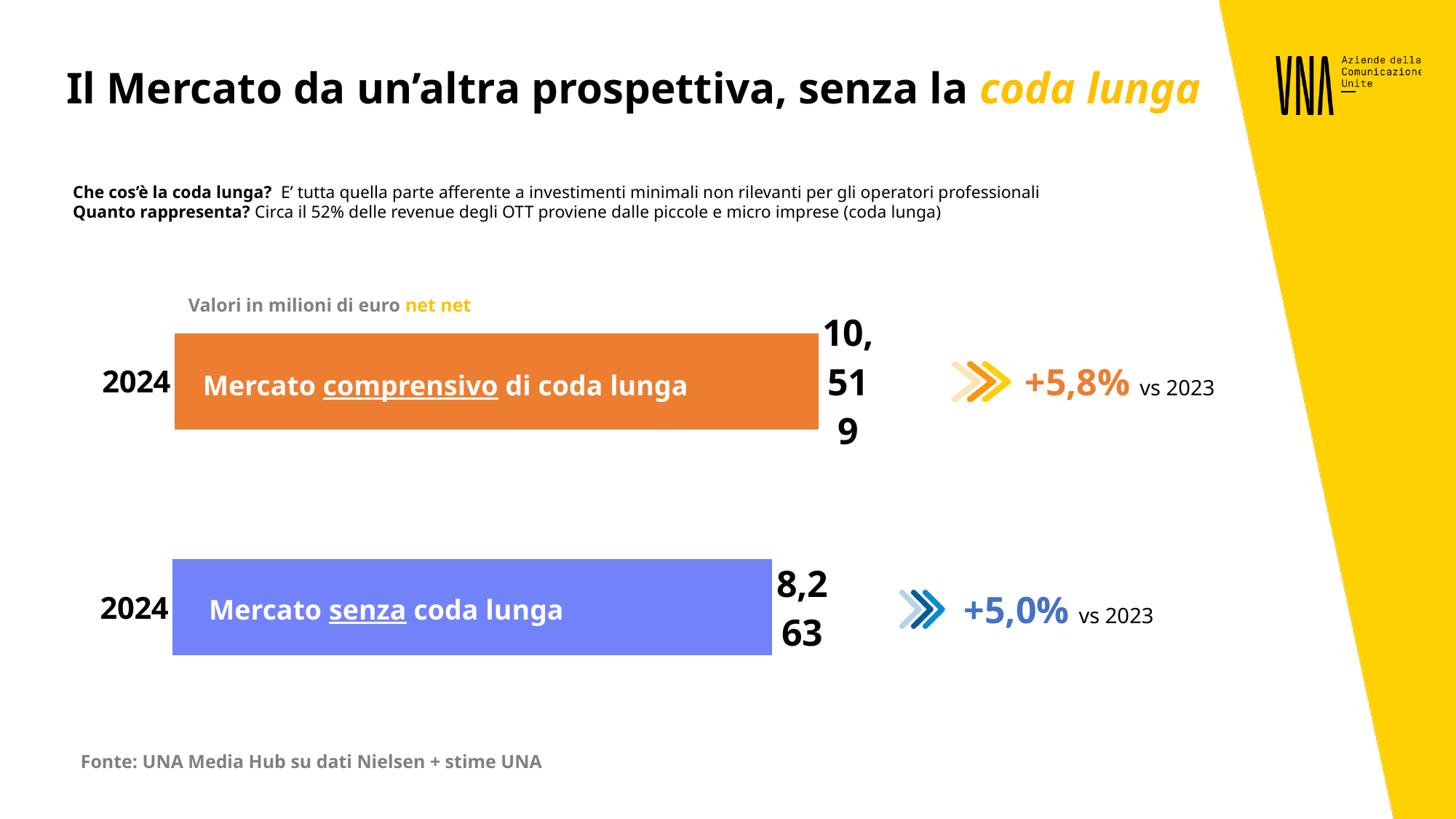
In what unit are the values on the chart expressed? Milioni di euro net net What colour is the bar for 'Mercato senza coda lunga'? Blue What is the difference between the value for 'Mercato comprensivo di coda lunga' and 'Mercato senza coda lunga'? 2,256 What is the value for 'Mercato senza coda lunga' in 2024? 8,263 What is the growth vs 2023 shown for 'Mercato comprensivo di coda lunga'? +5,8% Which bar has the higher value, 'Mercato comprensivo di coda lunga' or 'Mercato senza coda lunga'? Mercato comprensivo di coda lunga Which category has the highest value on the chart? Mercato comprensivo di coda lunga How many bars are shown on the chart? 2 Which category has the lowest value on the chart? Mercato senza coda lunga What kind of chart is shown on the slide? Bar chart What is the value for 'Mercato comprensivo di coda lunga' in 2024? 10,519 What is the growth vs 2023 shown for 'Mercato senza coda lunga'? +5,0%